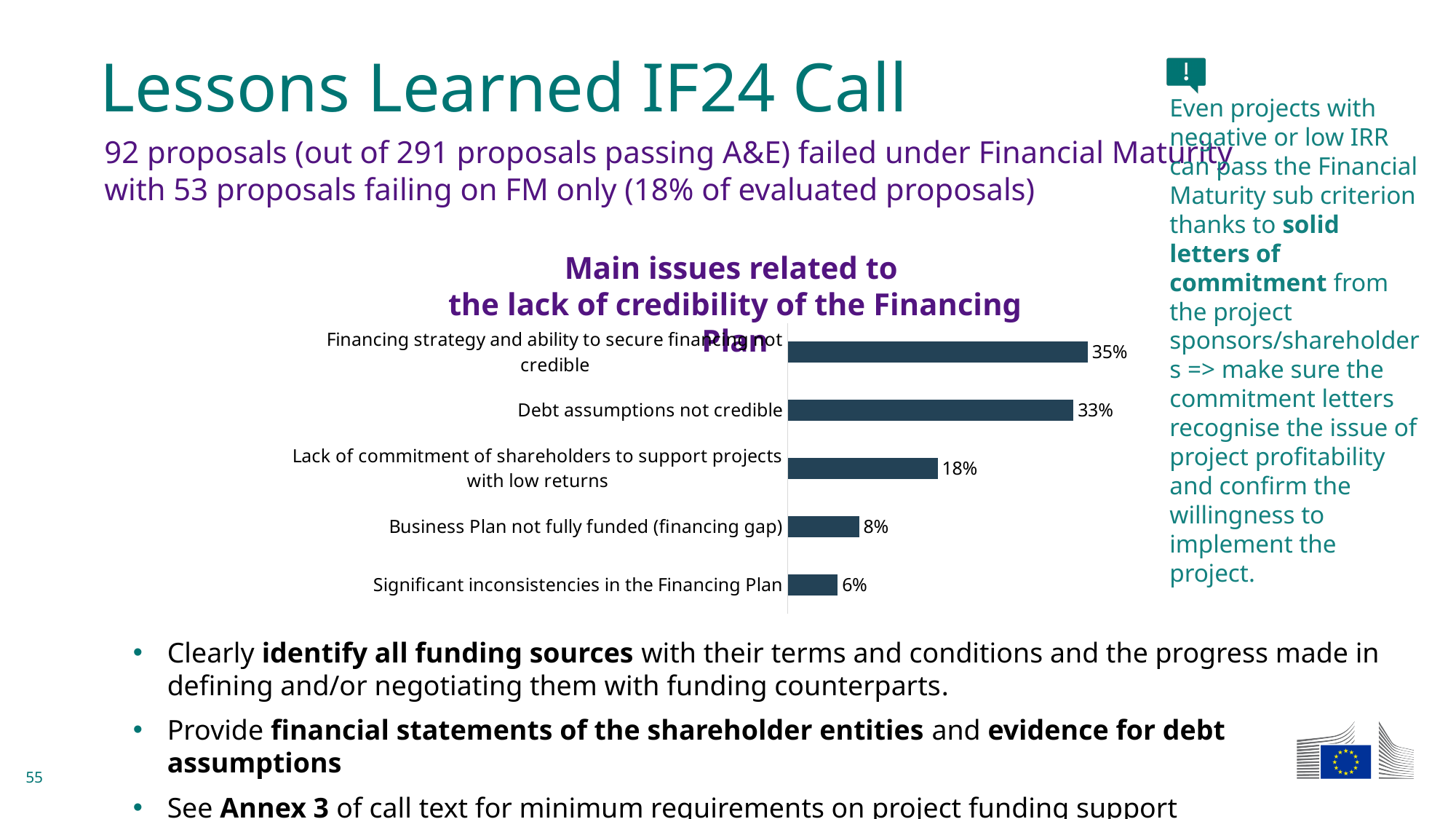
Which category has the lowest value? Significant inconsistencies in the Financing Plan What is the difference between the values for "Financing strategy and ability to secure financing not credible" and "Debt assumptions not credible"? 2% What is the value for "Business Plan not fully funded (financing gap)"? 8% Which category has the highest value? Financing strategy and ability to secure financing not credible What is the value for "Debt assumptions not credible"? 33% What kind of chart is shown on the slide? bar chart What is the value for "Significant inconsistencies in the Financing Plan"? 6% What is the value for "Lack of commitment of shareholders to support projects with low returns"? 18% What is the difference between the values for "Lack of commitment of shareholders to support projects with low returns" and "Business Plan not fully funded (financing gap)"? 10% How many categories are shown in the chart? 5 Which is larger: the value for "Business Plan not fully funded (financing gap)" or the value for "Significant inconsistencies in the Financing Plan"? Business Plan not fully funded (financing gap) What is the title of the chart? Main issues related to the lack of credibility of the Financing Plan